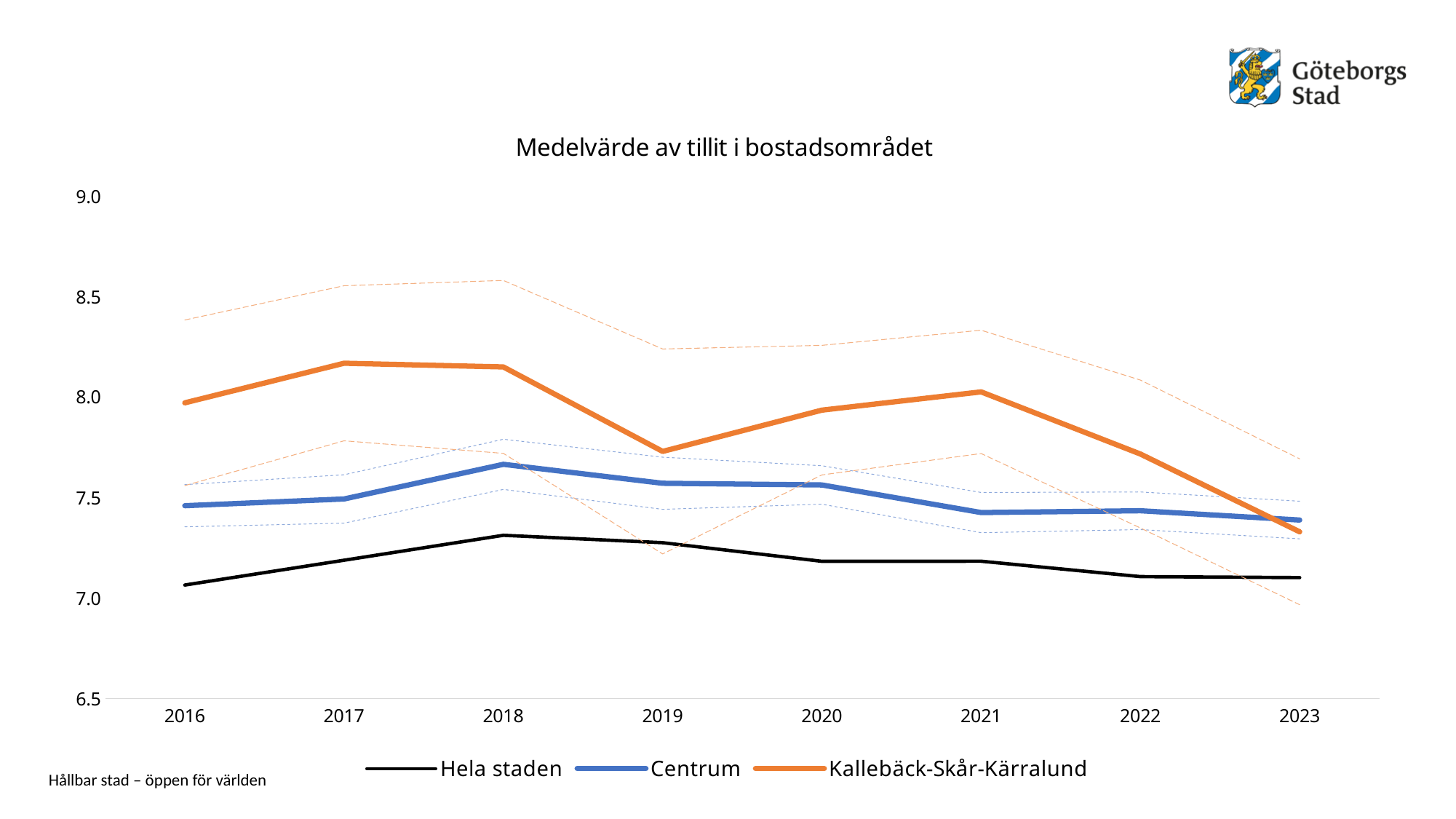
In 2018, which is higher: Kallebäck-Skår-Kärralund or Centrum? Kallebäck-Skår-Kärralund Which series is drawn in orange? Kallebäck-Skår-Kärralund In which year does Kallebäck-Skår-Kärralund reach its lowest value? 2023 Is the value for Kallebäck-Skår-Kärralund in 2019 greater or less than 8.0? less Is the value for Centrum in 2018 greater or less than 7.5? greater What is the title of the chart? Medelvärde av tillit i bostadsområdet Is the value for Hela staden in 2018 greater or less than 7.5? less How many series does the legend list? 3 In which year does Hela staden reach its highest value? 2018 What kind of chart is shown on the slide? line chart How many years are shown on the x axis? 8